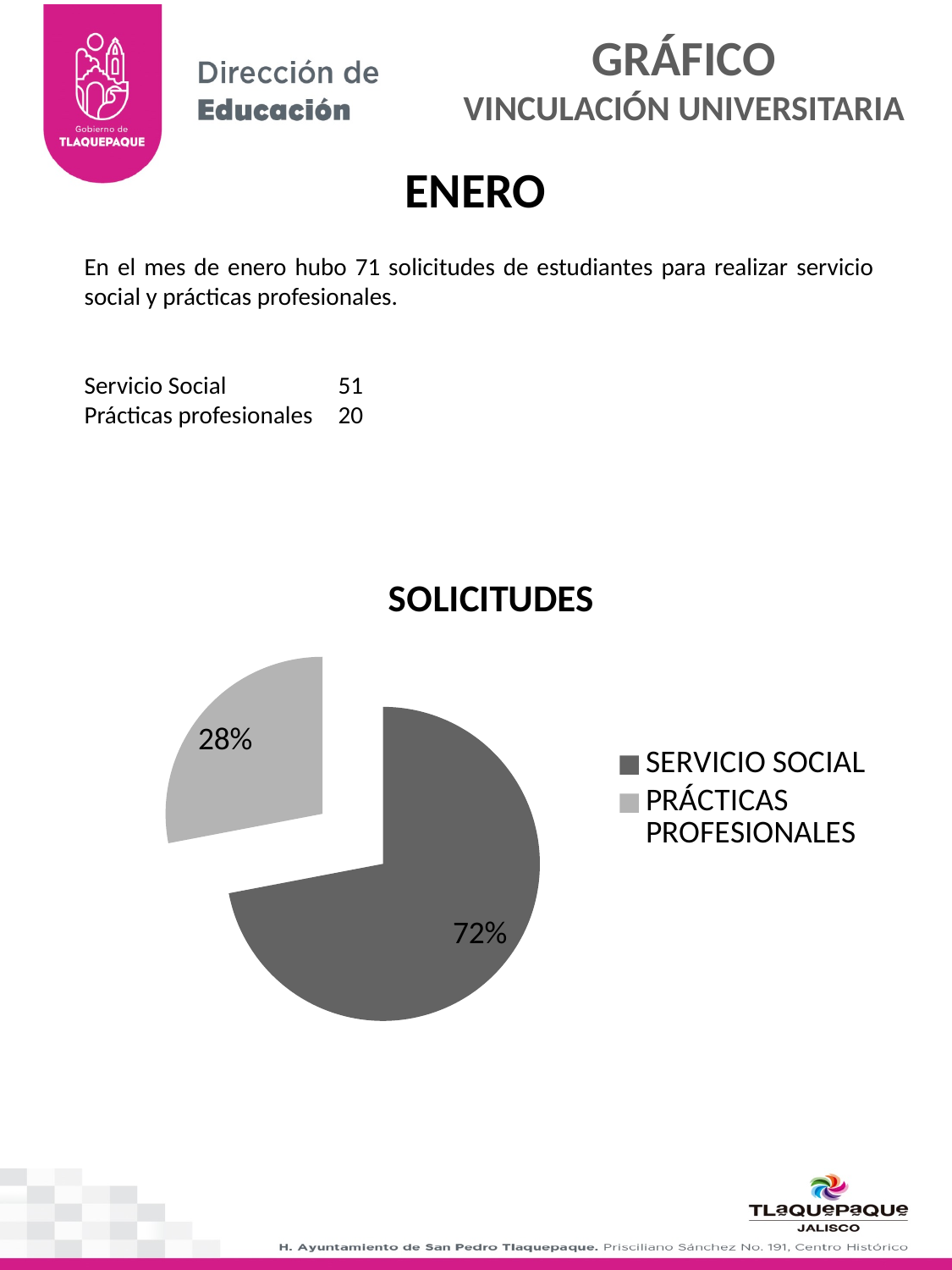
Which slice of the pie is the largest? SERVICIO SOCIAL Which legend entry is shown in the lighter grey colour? PRÁCTICAS PROFESIONALES How many slices does the pie chart have? 2 What share of the pie does SERVICIO SOCIAL represent? 72% Which slice of the pie is the smallest? PRÁCTICAS PROFESIONALES How many entries does the legend list? 2 What share of the pie does PRÁCTICAS PROFESIONALES represent? 28% What is the difference in percentage points between the SERVICIO SOCIAL and PRÁCTICAS PROFESIONALES slices? 44% Which is larger, the SERVICIO SOCIAL slice or the PRÁCTICAS PROFESIONALES slice? SERVICIO SOCIAL What is the title of the chart? SOLICITUDES What kind of chart is shown under the title SOLICITUDES? pie chart